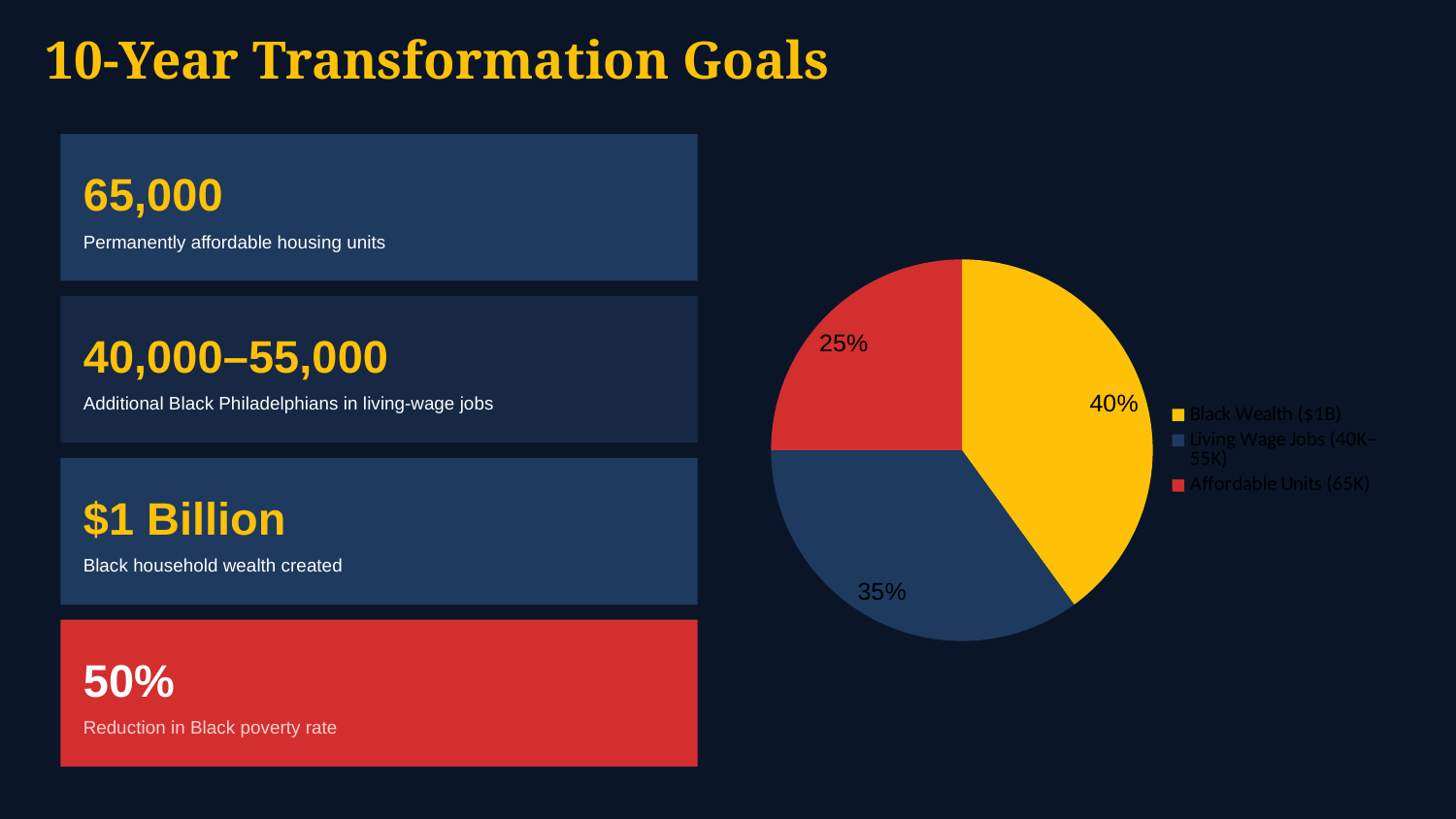
What share of the pie does the Affordable Units (65K) slice represent? 25% What share of the pie does the Black Wealth ($1B) slice represent? 40% How many entries does the pie chart's legend list? 3 Which slice of the pie is the largest? Black Wealth ($1B) Which slice of the pie is the smallest? Affordable Units (65K) What colour is the Affordable Units (65K) slice in the pie chart? red What kind of chart is shown on the slide? pie chart How many slices does the pie chart have? 3 What colour is the Black Wealth ($1B) slice in the pie chart? yellow Which is larger, the Living Wage Jobs (40K–55K) slice or the Affordable Units (65K) slice? Living Wage Jobs (40K–55K) What share of the pie does the Living Wage Jobs (40K–55K) slice represent? 35% What is the difference in percentage points between the Black Wealth ($1B) slice and the Affordable Units (65K) slice? 15